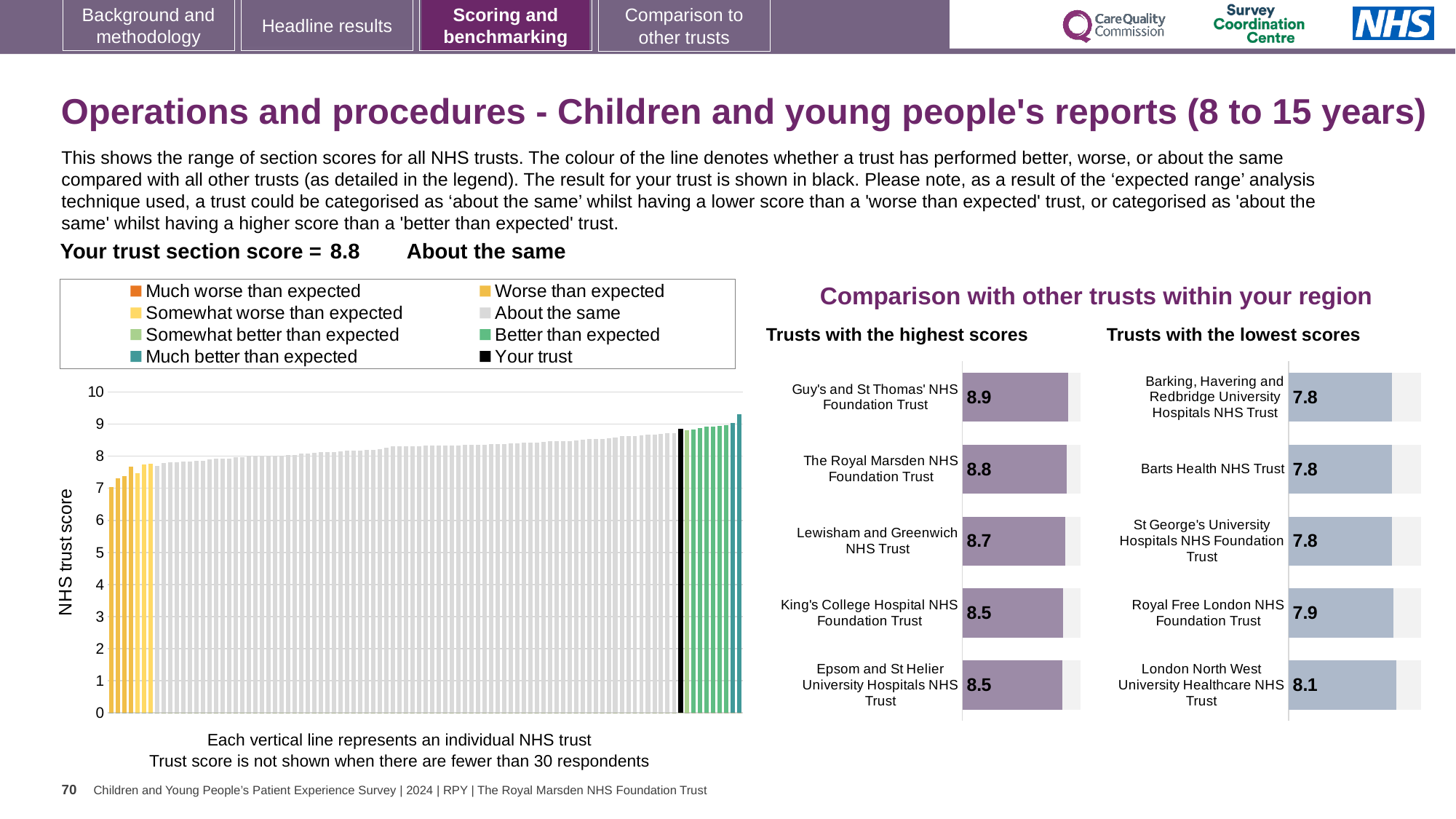
In the 'Trusts with the highest scores' chart, what is the score for Guy's and St Thomas' NHS Foundation Trust? 8.9 In the 'Trusts with the lowest scores' chart, what is the score for London North West University Healthcare NHS Trust? 8.1 In the 'Trusts with the highest scores' chart, which trust has the highest score? Guy's and St Thomas' NHS Foundation Trust In the 'Trusts with the highest scores' chart, how many trusts are shown? 5 In the 'Trusts with the lowest scores' chart, what is the score for Royal Free London NHS Foundation Trust? 7.9 In the 'Trusts with the lowest scores' chart, which trust has the highest score? London North West University Healthcare NHS Trust In the 'Trusts with the lowest scores' chart, what is the difference between the scores of London North West University Healthcare NHS Trust and Royal Free London NHS Foundation Trust? 0.2 In the 'Trusts with the highest scores' chart, what is the difference between the scores of Guy's and St Thomas' NHS Foundation Trust and King's College Hospital NHS Foundation Trust? 0.4 In the 'Trusts with the lowest scores' chart, which is larger: the score for London North West University Healthcare NHS Trust or the score for Barts Health NHS Trust? London North West University Healthcare NHS Trust In the 'Trusts with the highest scores' chart, what is the score for Lewisham and Greenwich NHS Trust? 8.7 In the chart on the left with the y axis labelled 'NHS trust score', do the bar values rise or fall from left to right? Rise What kind of chart is the chart on the left with the y axis labelled 'NHS trust score'? Bar chart